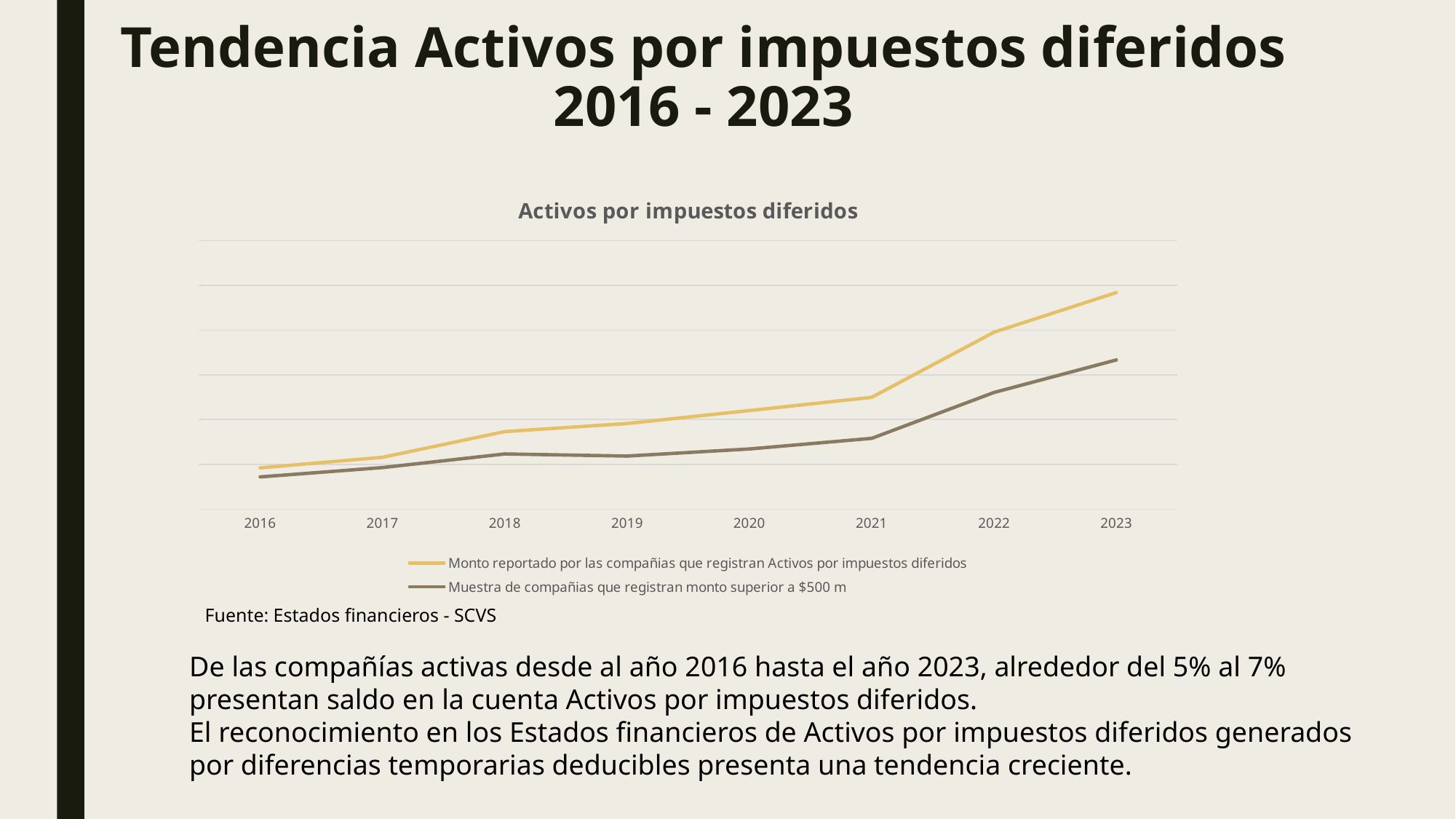
In which year does the series 'Muestra de compañias que registran monto superior a $500 m' reach its highest value? 2023 Do the values of the series 'Muestra de compañias que registran monto superior a $500 m' rise or fall from 2021 to 2023? Rise What is the title of the chart? Activos por impuestos diferidos Which series is shown with the yellow line in the chart? Monto reportado por las compañias que registran Activos por impuestos diferidos For the series 'Monto reportado por las compañias que registran Activos por impuestos diferidos', which year has the larger value: 2019 or 2022? 2022 Do the values of the series 'Monto reportado por las compañias que registran Activos por impuestos diferidos' rise or fall from 2016 to 2023? Rise In 2023, which series has the larger value: 'Monto reportado por las compañias que registran Activos por impuestos diferidos' or 'Muestra de compañias que registran monto superior a $500 m'? Monto reportado por las compañias que registran Activos por impuestos diferidos How many series does the legend of the chart list? 2 In which year does the series 'Monto reportado por las compañias que registran Activos por impuestos diferidos' reach its highest value? 2023 In which year does the series 'Muestra de compañias que registran monto superior a $500 m' have its lowest value? 2016 What kind of chart is shown on the slide? Line chart How many years are plotted along the x axis of the chart? 8